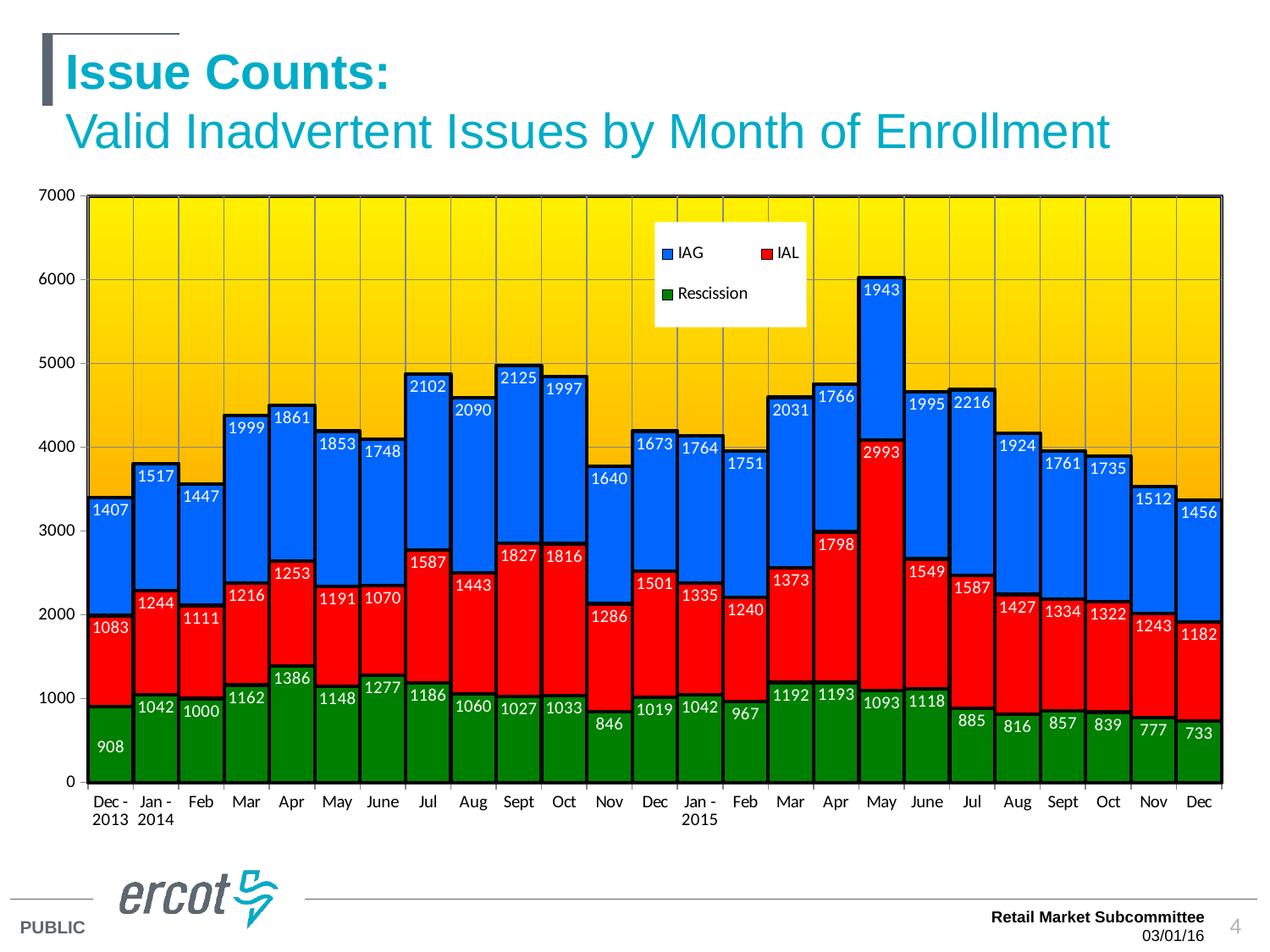
What is the difference between the IAL values for May 2015 and Apr 2015? 1195 Which month has the lowest Rescission value? Dec 2015 What kind of chart is shown on the slide? Stacked bar chart Is the total stacked value for May 2015 greater or less than 5000? greater How many months are shown on the x axis? 25 How many series does the legend list? 3 What is the total stacked value for May 2015? 6029 Which is larger, the IAG value for Sept 2014 or the IAG value for Oct 2014? Sept 2014 What is the IAG value for Jul 2015? 2216 Which month has the highest IAL value? May 2015 What is the Rescission value for Dec 2013? 908 What is the IAL value for May 2015? 2993